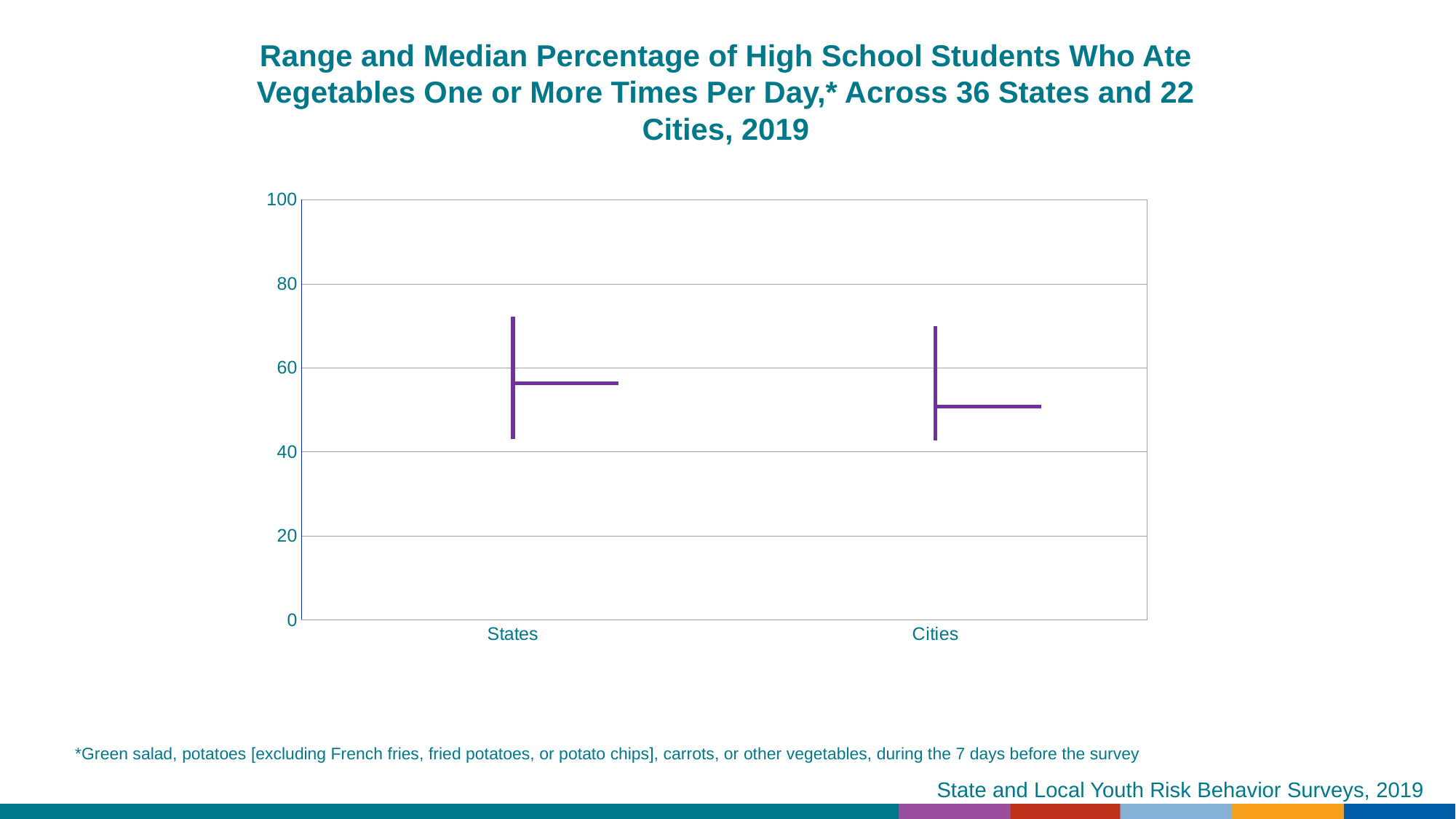
Is the top of the range for States greater or less than 80? less Is the median value for Cities greater or less than 60? less Is the median value for States greater or less than 60? less How many categories are shown on the x axis of the chart? 2 What are the two categories shown on the x axis? States and Cities What kind of chart is shown on the slide? range and median (high-low) chart What is the maximum value shown on the y axis? 100 Which category has the higher median value, States or Cities? States